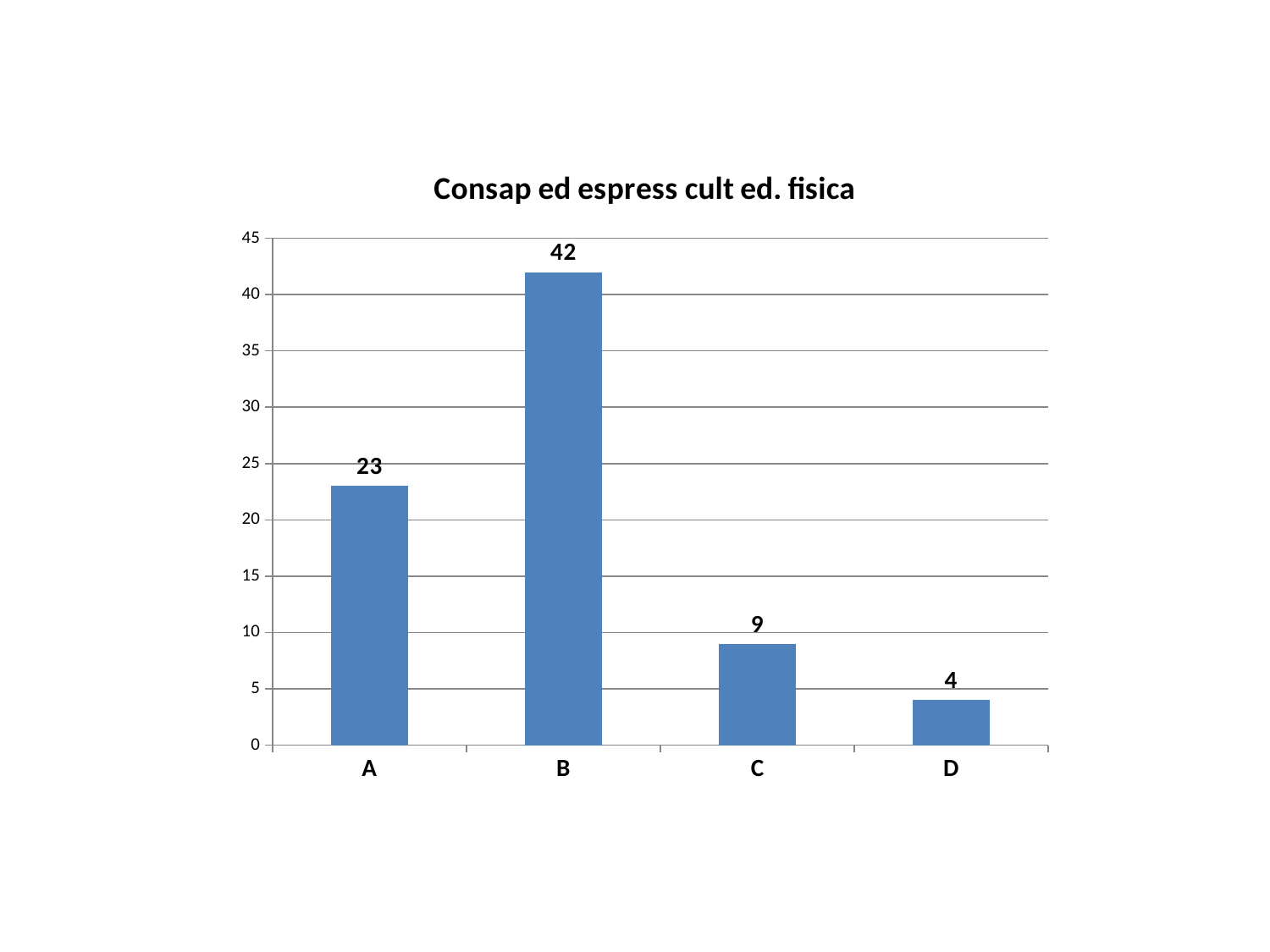
How many categories are shown on the x axis? 4 Which is larger, the value for C or the value for D? C Which category has the highest value? B What is the value for category C? 9 What is the title of the chart? Consap ed espress cult ed. fisica What kind of chart is shown on the slide? bar chart What is the difference between the values for B and A? 19 Which category has the lowest value? D What is the value for category A? 23 What is the value for category D? 4 What is the value for category B? 42 Is the value for A greater or less than 20? greater